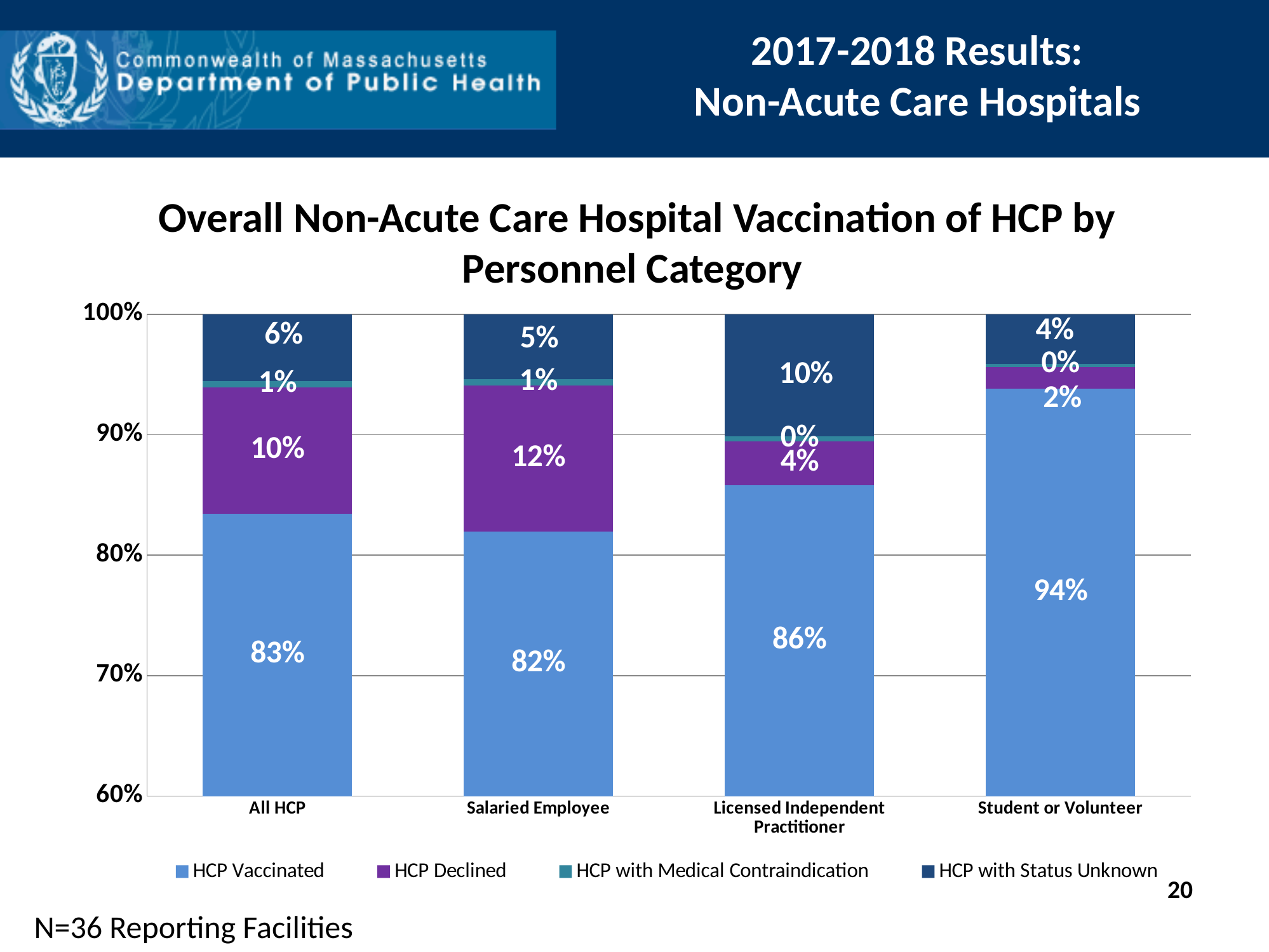
Which personnel category has the highest HCP Vaccinated percentage? Student or Volunteer How many personnel categories are shown on the x axis? 4 What kind of chart is shown on the slide? Stacked bar chart How many series does the legend list? 4 What percentage of All HCP were vaccinated? 83% Which is larger, the HCP Declined value for All HCP or for Licensed Independent Practitioner? All HCP What is the HCP Vaccinated value for Student or Volunteer? 94% What is the title of the chart? Overall Non-Acute Care Hospital Vaccination of HCP by Personnel Category What is the HCP with Status Unknown value for Licensed Independent Practitioner? 10% What is the HCP Declined value for Salaried Employee? 12% What is the difference between the HCP Vaccinated percentage for Student or Volunteer and for Salaried Employee? 12% Which personnel category has the lowest HCP Vaccinated percentage? Salaried Employee